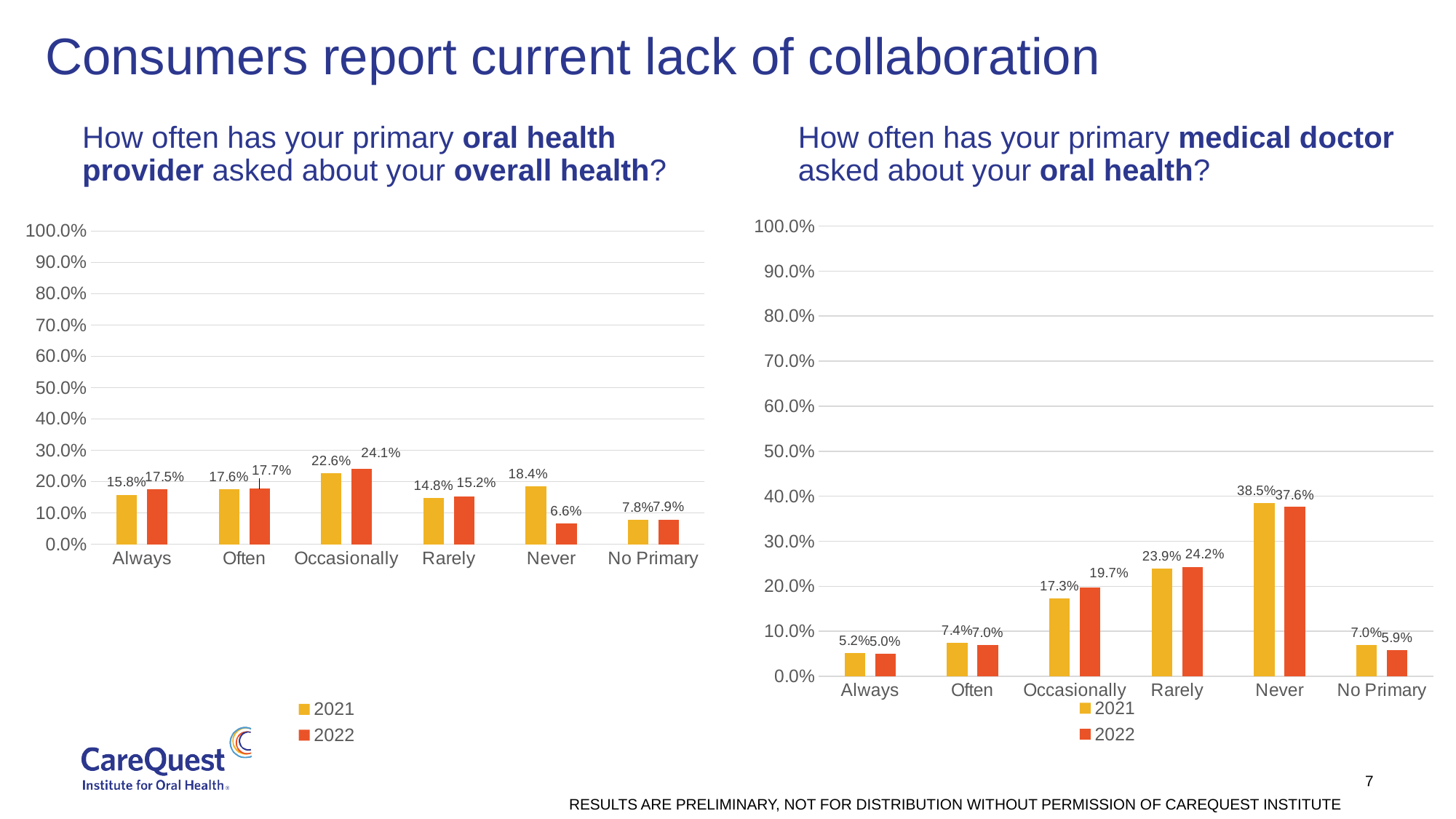
In the left chart (oral health provider asked about overall health), what is the 2021 value for Never? 18.4% In the right chart (medical doctor asked about oral health), which category has the lowest 2021 value? Always In the right chart (medical doctor asked about oral health), what is the 2021 value for Never? 38.5% In the left chart (oral health provider asked about overall health), which category has the highest 2021 value? Occasionally What type of chart is used on the right side of the slide? Bar chart In the right chart (medical doctor asked about oral health), is the 2021 value for Occasionally larger or the 2022 value? 2022 In the right chart (medical doctor asked about oral health), which category has the highest 2022 value? Never In the left chart (oral health provider asked about overall health), what is the 2022 value for Occasionally? 24.1% In the right chart (medical doctor asked about oral health), what is the 2022 value for Rarely? 24.2% In the left chart (oral health provider asked about overall health), what is the difference between the 2021 and 2022 values for Never? 11.8% How many categories are shown on the x axis of the left chart? 6 How many series does the legend of the right chart list? 2